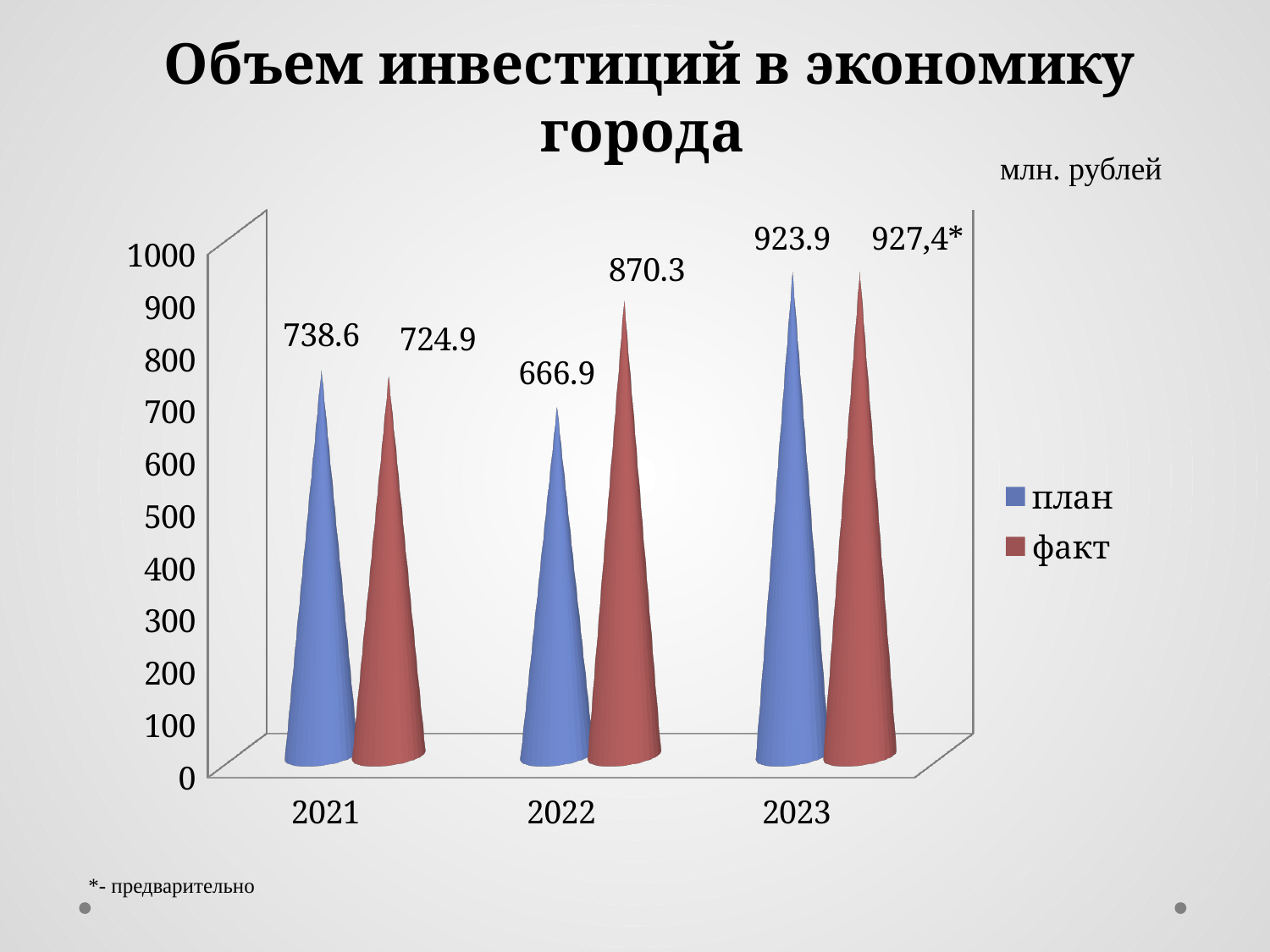
What is the value for план in 2021? 738.6 Is the value for план in 2022 greater or less than 700? less In which year is the факт value the highest? 2023 What is the difference between факт and план in 2022? 203.4 Which is larger in 2021, план or факт? план In which year is the план value the lowest? 2022 What is the value for факт in 2023? 927,4* What kind of chart is shown on the slide? bar chart How many series does the legend list? 2 What is the value for факт in 2022? 870.3 How many years are shown on the x axis? 3 Do the факт values rise or fall from 2021 to 2023? rise